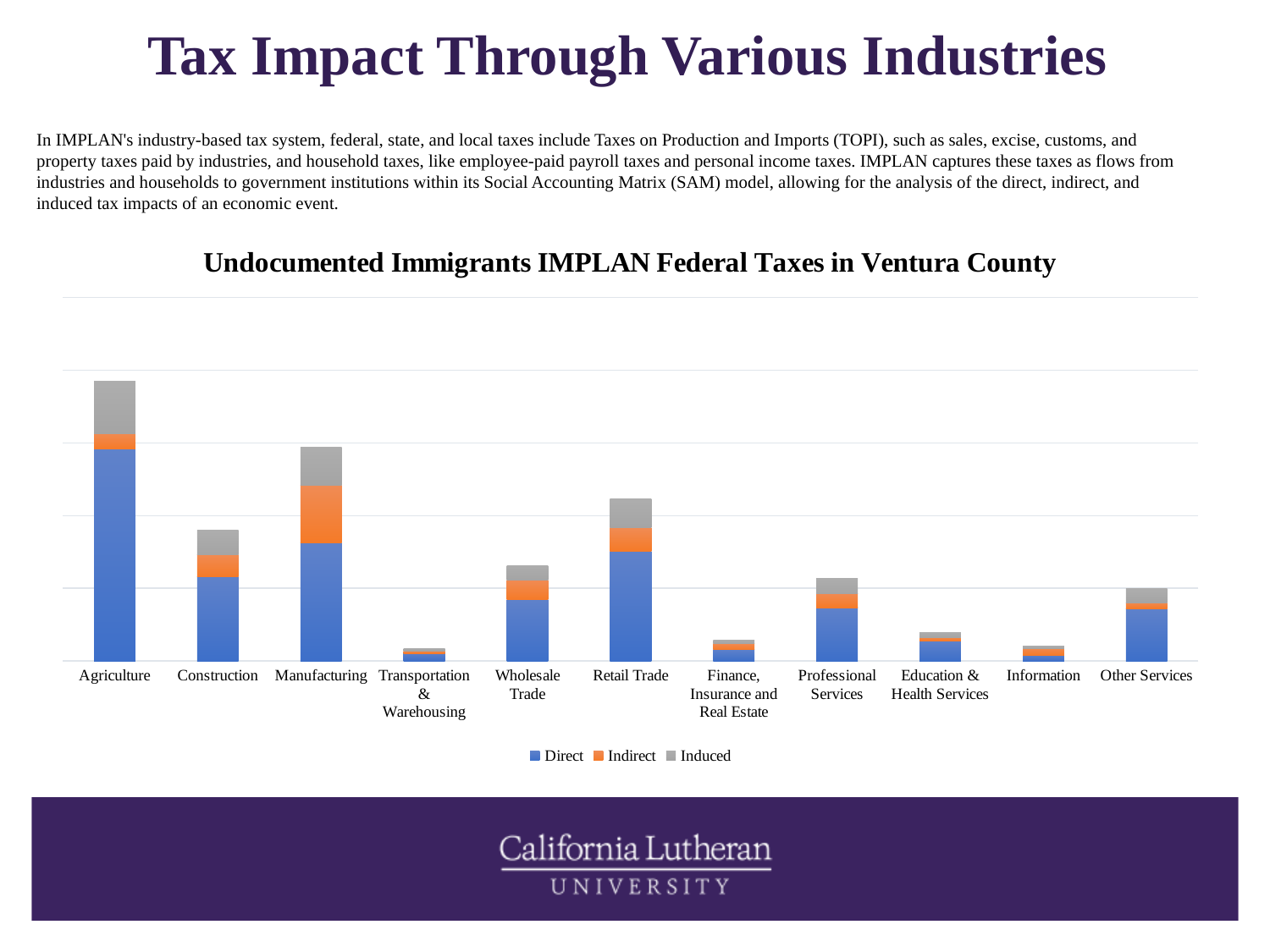
Which has the taller total bar, Construction or Wholesale Trade? Construction Which industry has the highest total federal tax bar? Agriculture What is the title of the chart? Undocumented Immigrants IMPLAN Federal Taxes in Ventura County Which has the taller total bar, Agriculture or Retail Trade? Agriculture Which industry has the largest Direct segment? Agriculture Which has the taller total bar, Manufacturing or Retail Trade? Manufacturing What kind of chart is shown on the slide? Stacked bar chart How many series does the legend list? 3 Which industry has the largest Indirect segment? Manufacturing Which series is shown in orange in the legend? Indirect How many industry categories are shown on the x axis? 11